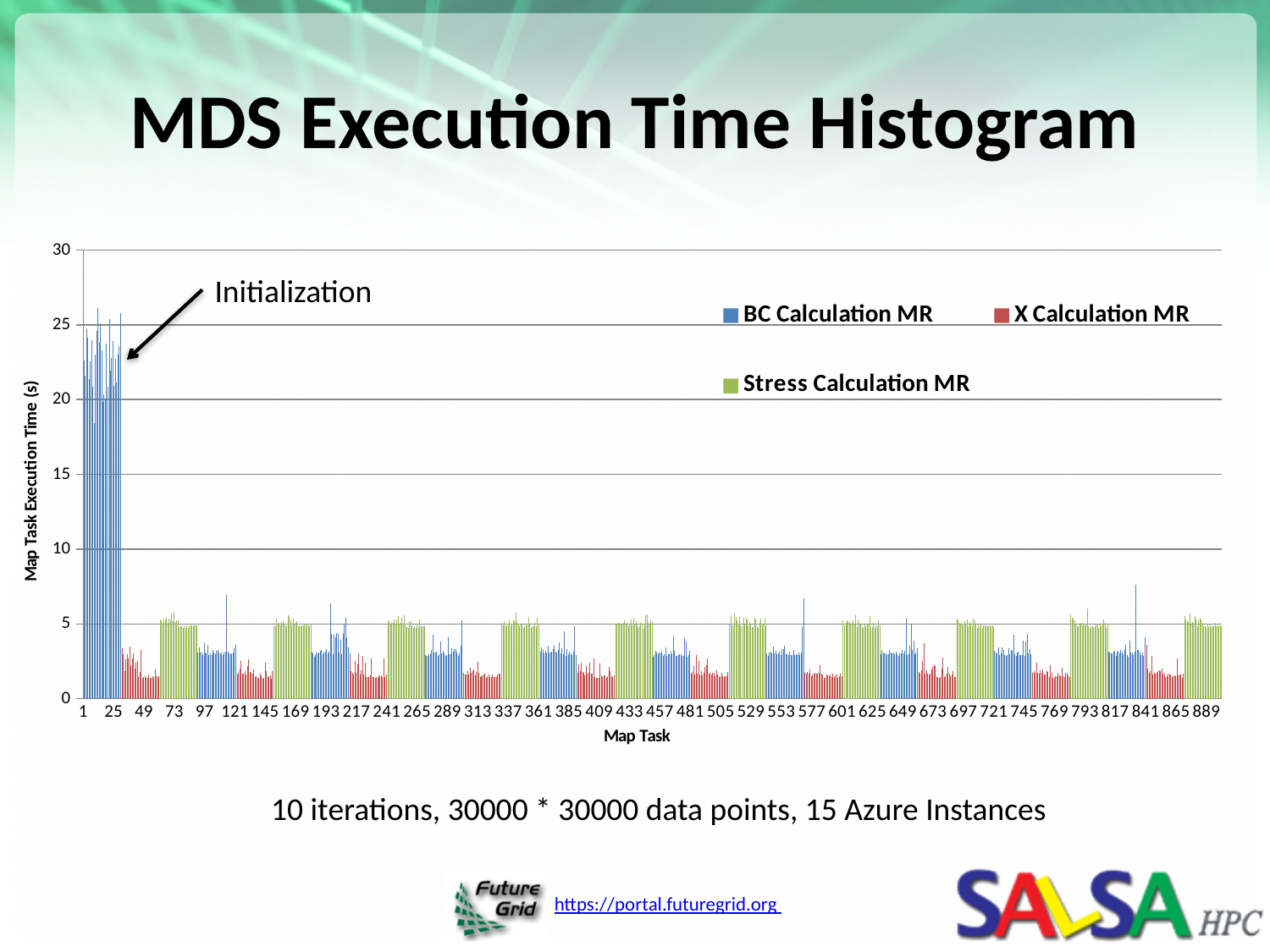
What kind of chart is shown on the slide? bar chart After the initial group of tall bars, do the BC Calculation MR bars rise or fall compared with the initialization bars? fall Are the tallest bars at the start of the chart (the initialization bars) greater or less than 20 seconds? greater Are the X Calculation MR bars greater or less than 5 seconds? less Which series contains the tallest bars in the chart? BC Calculation MR Which series does the legend show in blue? BC Calculation MR Which series has the lowest bars overall? X Calculation MR Which series has taller bars, Stress Calculation MR or X Calculation MR? Stress Calculation MR What is the label of the y axis? Map Task Execution Time (s) What is the highest value shown on the y axis? 30 Are the Stress Calculation MR bars greater or less than 10 seconds? less How many series does the legend list? 3